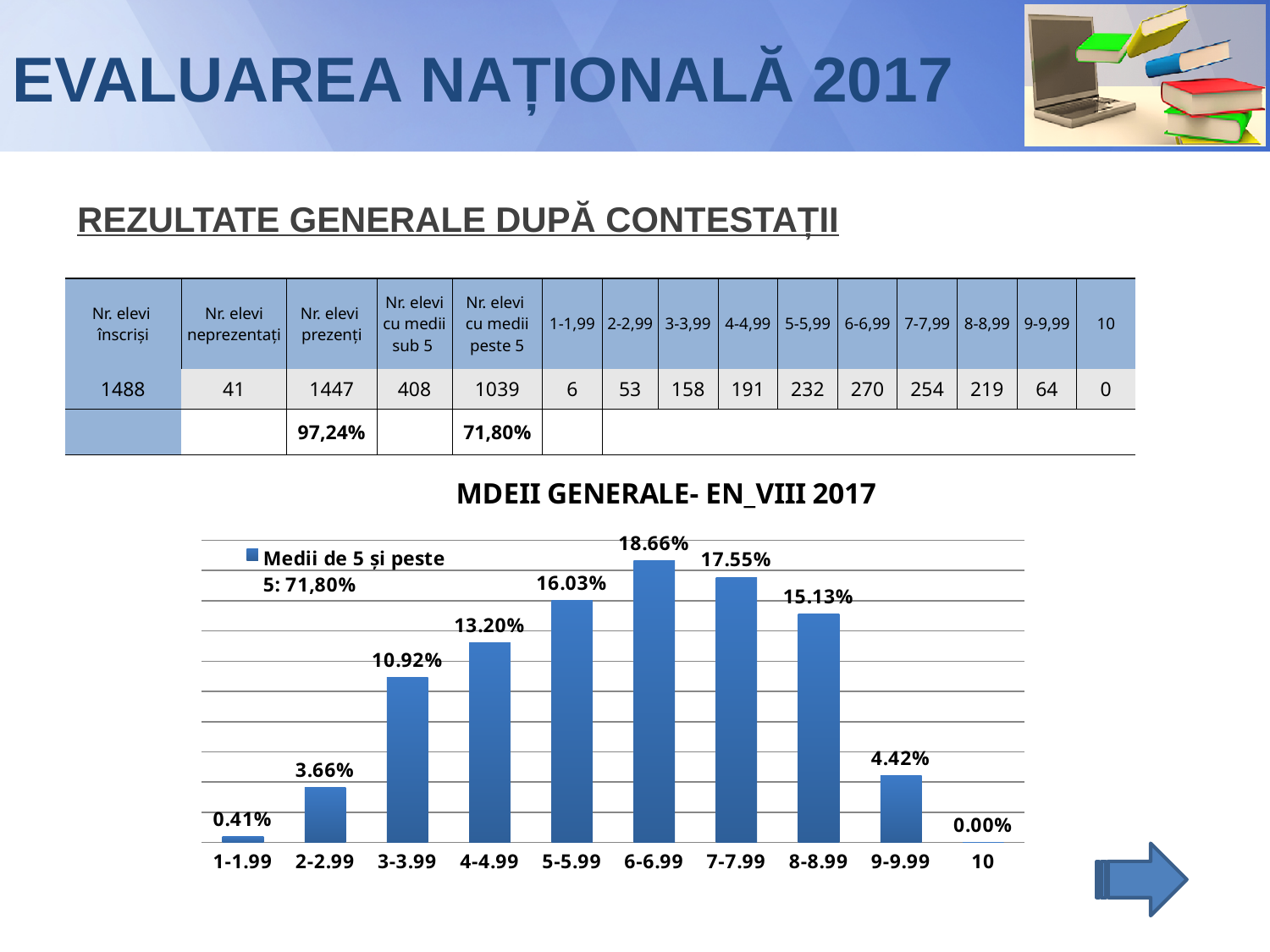
Do the values rise or fall from 1-1.99 to 6-6.99? rise Which category has the highest value? 6-6.99 What is the title of the chart? MDEII GENERALE- EN_VIII 2017 Which is larger, the value for 5-5.99 or the value for 8-8.99? 5-5.99 What is the difference between the values for 6-6.99 and 7-7.99? 1.11% What is the value for the 1-1.99 category? 0.41% What is the value for the 9-9.99 category? 4.42% What is the difference between the values for 3-3.99 and 2-2.99? 7.26% What kind of chart is shown? bar chart How many categories are shown on the x axis? 10 Which category has the lowest value? 10 What is the value for the 6-6.99 category? 18.66%